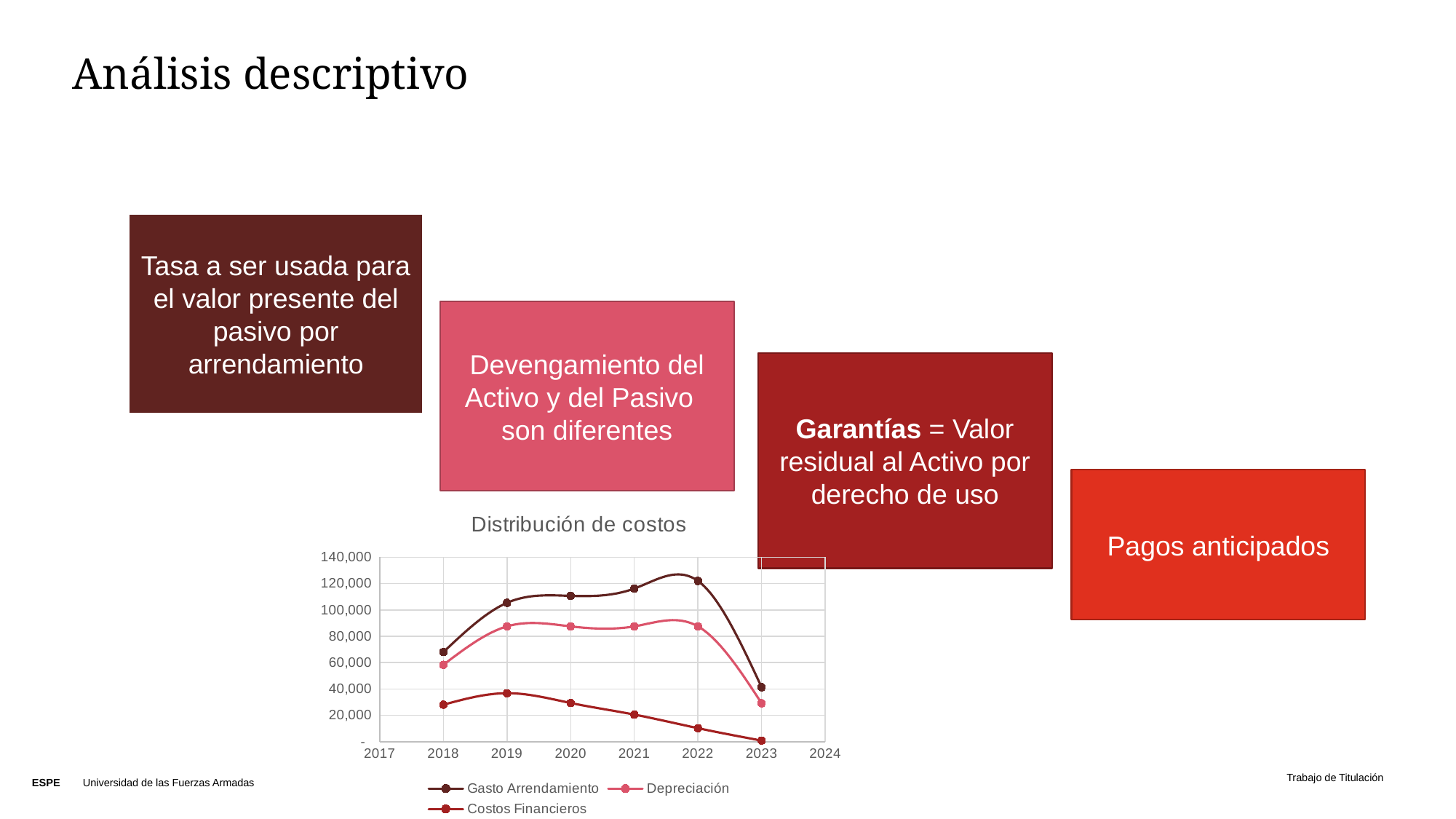
How many series does the legend of the 'Distribución de costos' chart list? 3 What are the series names in the legend of the 'Distribución de costos' chart? Gasto Arrendamiento, Depreciación, Costos Financieros In the 'Distribución de costos' chart, in which year is Gasto Arrendamiento lowest? 2023 In the 'Distribución de costos' chart, in which year is Depreciación lowest? 2023 In the 'Distribución de costos' chart, is the value of Gasto Arrendamiento in 2018 greater or less than 80,000? less In the 'Distribución de costos' chart, which is larger in 2023: Gasto Arrendamiento or Depreciación? Gasto Arrendamiento In the 'Distribución de costos' chart, does Costos Financieros rise or fall from 2019 to 2023? fall In the 'Distribución de costos' chart, in which year is Gasto Arrendamiento highest? 2022 In the 'Distribución de costos' chart, in which year is Costos Financieros highest? 2019 In the 'Distribución de costos' chart, is the value of Costos Financieros in 2022 greater or less than 20,000? less What kind of chart is 'Distribución de costos'? line chart How many data points does the Gasto Arrendamiento line have in the 'Distribución de costos' chart? 6